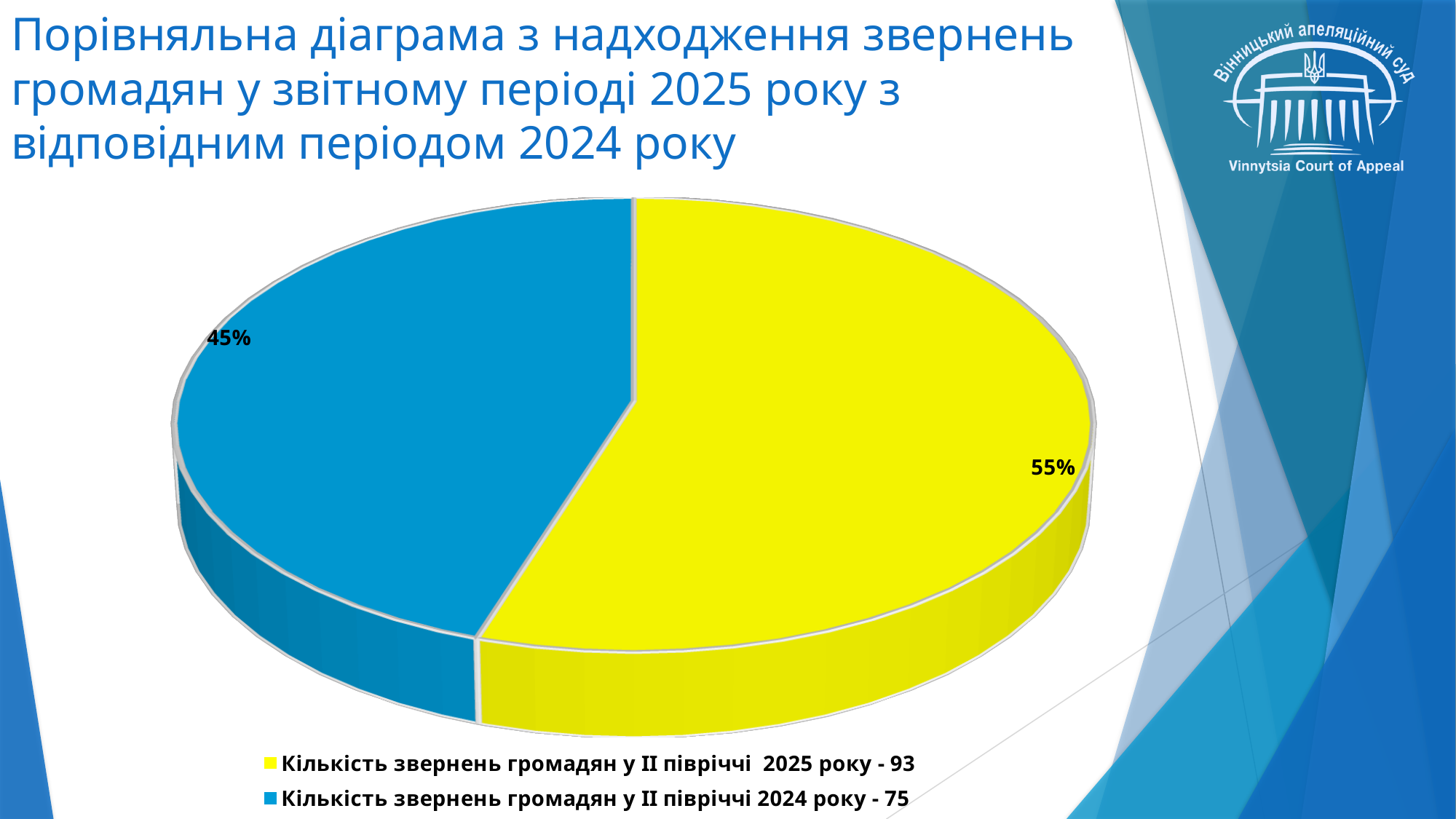
Which period has the larger slice of the pie? II half of 2025 What share of the pie does the slice for appeals in the II half of 2025 represent? 55% How many slices does the pie chart have? 2 According to the legend, how many citizen appeals were received in the II half of 2024? 75 What kind of chart is shown on the slide? pie chart According to the legend, how many citizen appeals were received in the II half of 2025? 93 Which is larger: the share for the II half of 2025 or the share for the II half of 2024? II half of 2025 What is the difference in percentage points between the 2025 slice and the 2024 slice? 10 By how many appeals does the II half of 2025 exceed the II half of 2024? 18 What share of the pie does the slice for appeals in the II half of 2024 represent? 45% Which period has the smaller slice of the pie? II half of 2024 What colour is the slice for the II half of 2025? yellow